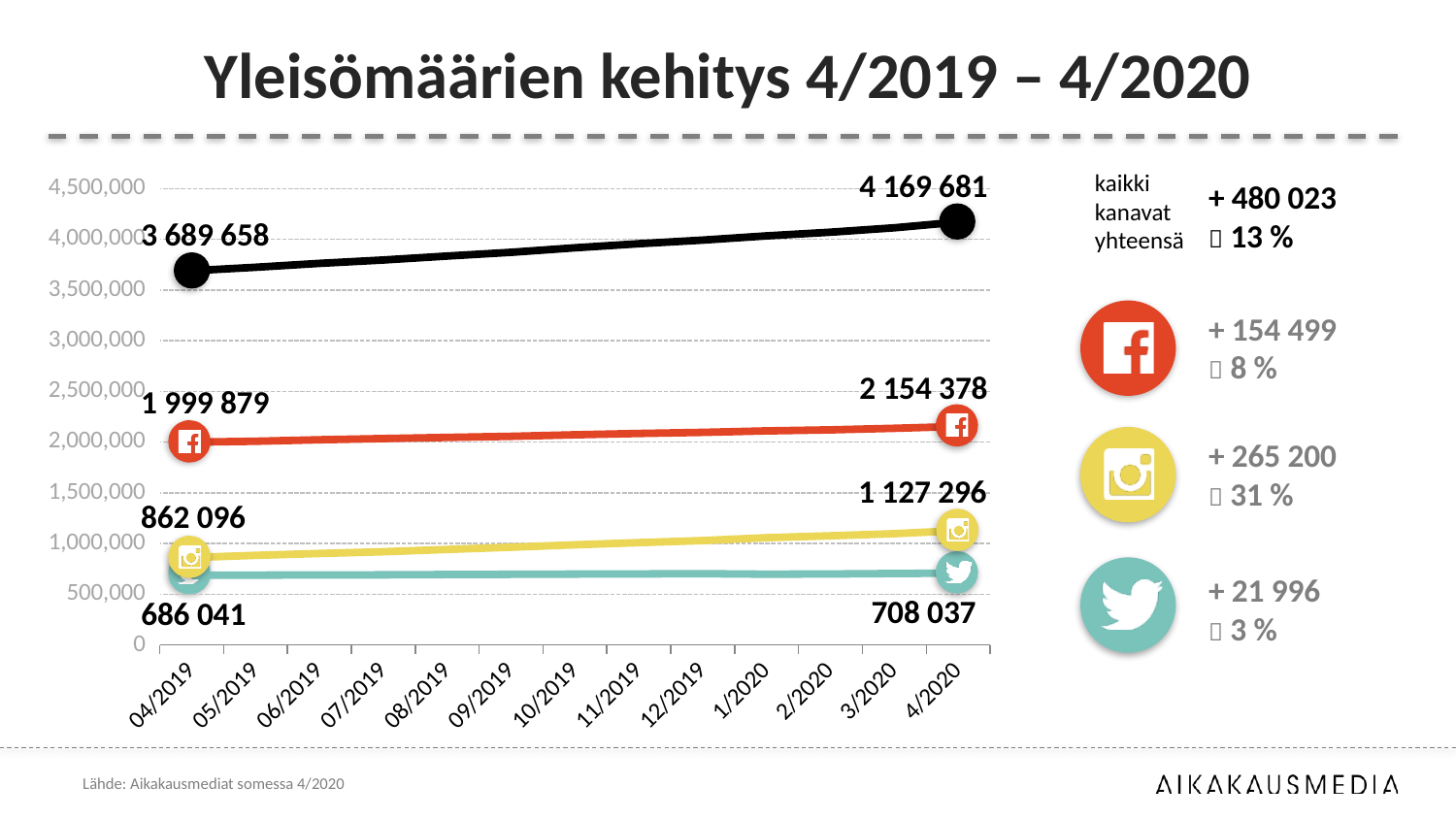
Does the Instagram line rise or fall from 04/2019 to 4/2020? Rise What is the value of the Facebook line at 4/2020? 2 154 378 Which line has the lowest value at 4/2020? Twitter Which is larger at 04/2019: the Facebook value or the Instagram value? Facebook By how much did the black (top) line increase from 04/2019 to 4/2020? 480 023 How many months are shown on the x axis? 13 What is the difference between the Instagram value at 4/2020 and at 04/2019? 265 200 What is the title of the chart? Yleisömäärien kehitys 4/2019 – 4/2020 What is the value of the Instagram line at 04/2019? 862 096 What type of chart is shown on the slide? Line chart What is the value of the Twitter line at 4/2020? 708 037 What is the value of the black (top) line at 04/2019? 3 689 658